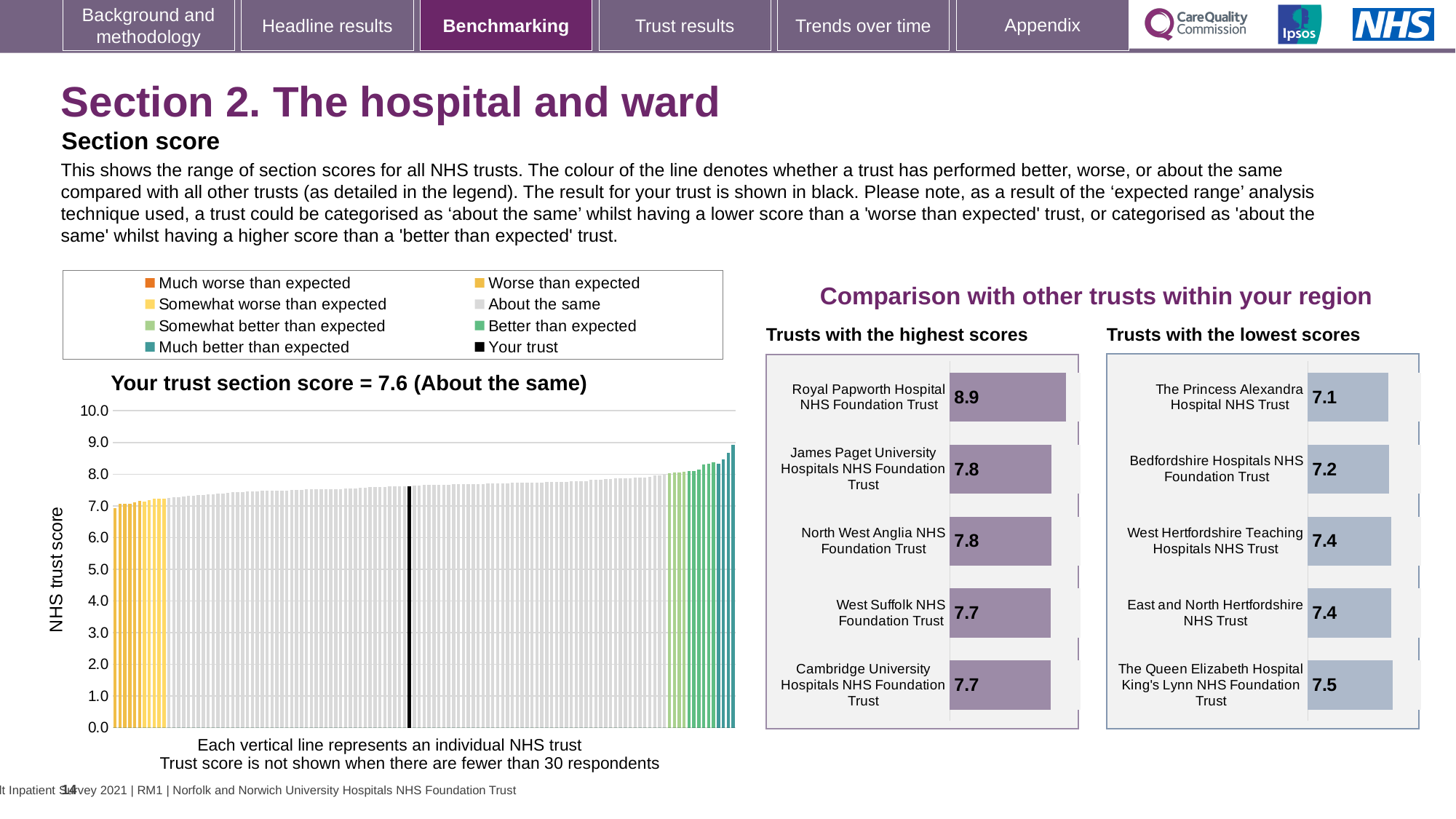
How many trusts are shown in the 'Trusts with the highest scores' chart? 5 In the 'Trusts with the lowest scores' chart, which trust has the lowest score? The Princess Alexandra Hospital NHS Trust In the 'Trusts with the highest scores' chart, what is the difference between the scores of Royal Papworth Hospital NHS Foundation Trust and Cambridge University Hospitals NHS Foundation Trust? 1.2 In the main chart on the left, what is your trust's section score? 7.6 In the 'Trusts with the lowest scores' chart, what is the score for The Princess Alexandra Hospital NHS Trust? 7.1 In the 'Trusts with the lowest scores' chart, what is the difference between the scores of The Queen Elizabeth Hospital King's Lynn NHS Foundation Trust and The Princess Alexandra Hospital NHS Trust? 0.4 What kind of chart is the main chart on the left showing the range of section scores? Bar chart How many entries does the legend above the main chart on the left list? 8 In the 'Trusts with the lowest scores' chart, which has the larger score: Bedfordshire Hospitals NHS Foundation Trust or The Queen Elizabeth Hospital King's Lynn NHS Foundation Trust? The Queen Elizabeth Hospital King's Lynn NHS Foundation Trust In the 'Trusts with the highest scores' chart, what is the score for Royal Papworth Hospital NHS Foundation Trust? 8.9 In the 'Trusts with the highest scores' chart, which trust has the highest score? Royal Papworth Hospital NHS Foundation Trust In the main chart on the left, which category is your trust's section score placed in? About the same